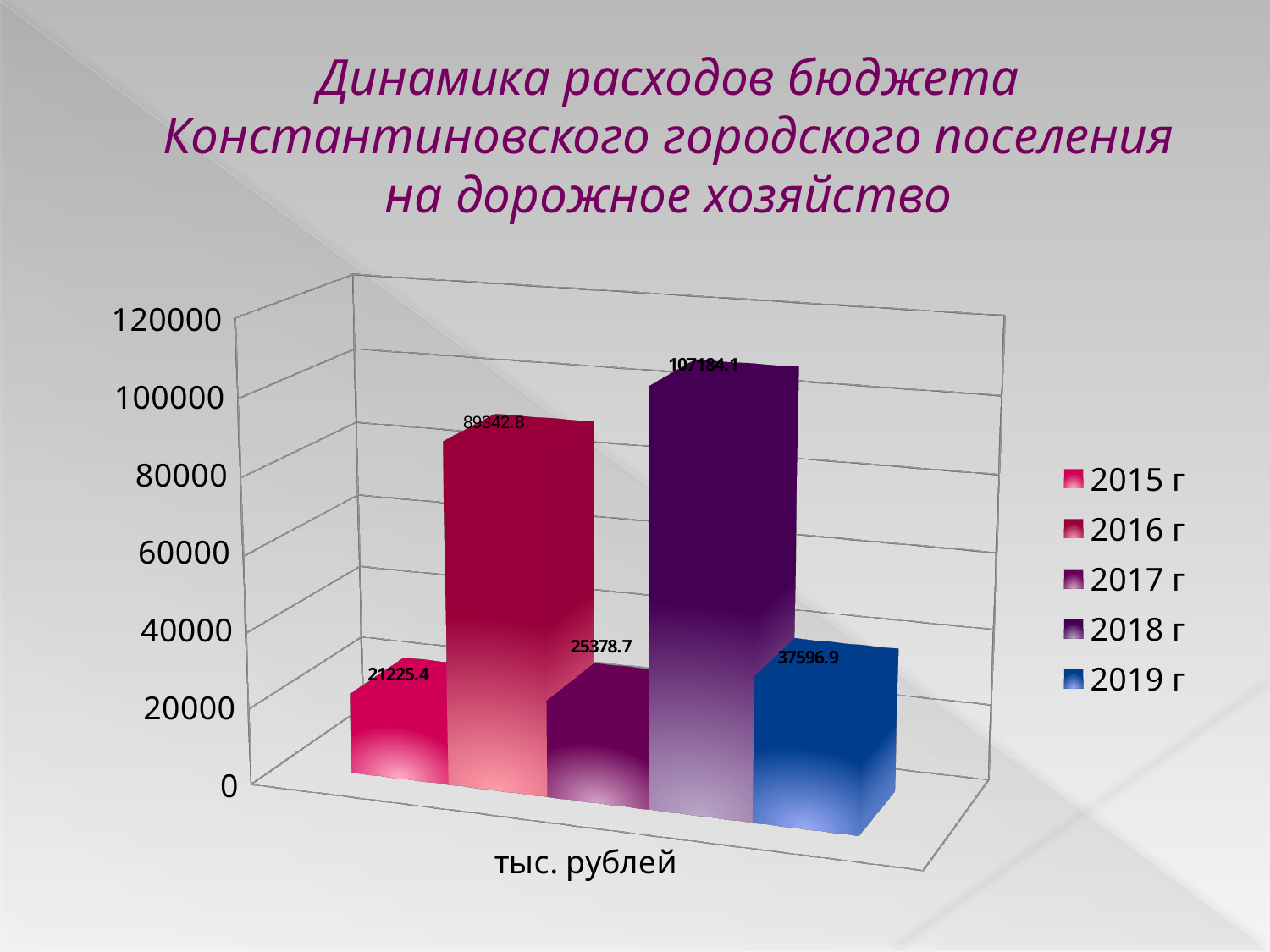
Which year has the highest value? 2018 г Which year has the lowest value? 2015 г How many series does the legend list? 5 What is the value for 2015 г? 21225.4 What is the difference between the values for 2019 г and 2015 г? 16371.5 What unit label is shown on the x axis of the chart? тыс. рублей Is the value for 2016 г greater or less than 80000? greater What is the difference between the values for 2018 г and 2016 г? 17841.3 What is the value for 2019 г? 37596.9 What is the value for 2018 г? 107184.1 Which is larger, the value for 2017 г or the value for 2019 г? 2019 г What kind of chart is shown on the slide? bar chart